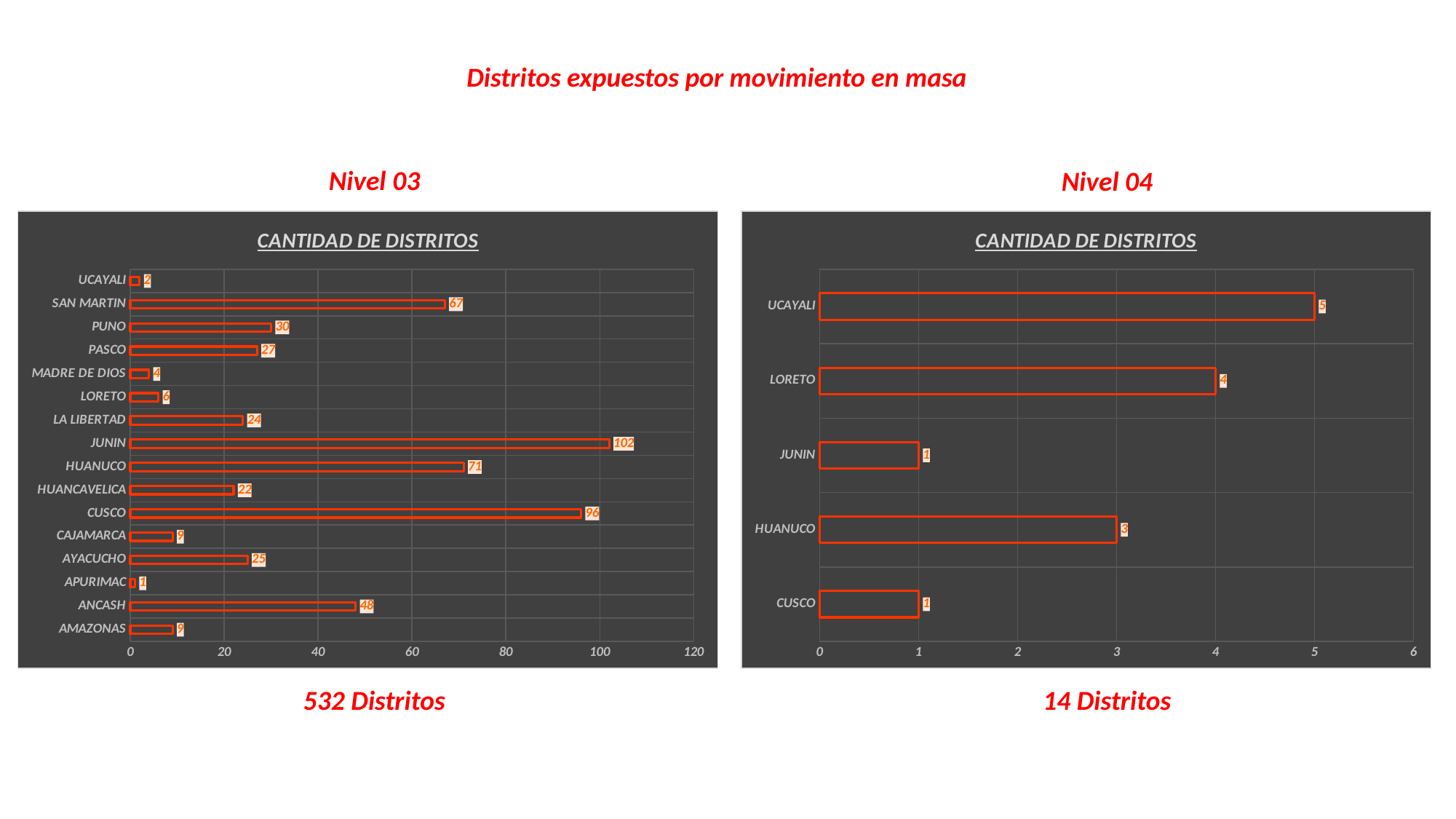
In the Nivel 04 chart, which category has the highest value? UCAYALI In the Nivel 03 chart, what is the value for SAN MARTIN? 67 In the Nivel 03 chart, which is larger, the value for PUNO or the value for PASCO? PUNO In the Nivel 04 chart, what is the value for LORETO? 4 In the Nivel 03 chart, how many categories are shown? 16 In the Nivel 03 chart, which category has the highest value? JUNIN What is the title shown inside both charts? CANTIDAD DE DISTRITOS In the Nivel 03 chart, what is the difference between the values for CUSCO and HUANUCO? 25 What kind of chart is the Nivel 04 chart? bar chart In the Nivel 04 chart, how many categories are shown? 5 In the Nivel 03 chart, which category has the lowest value? APURIMAC In the Nivel 03 chart, what is the value for JUNIN? 102